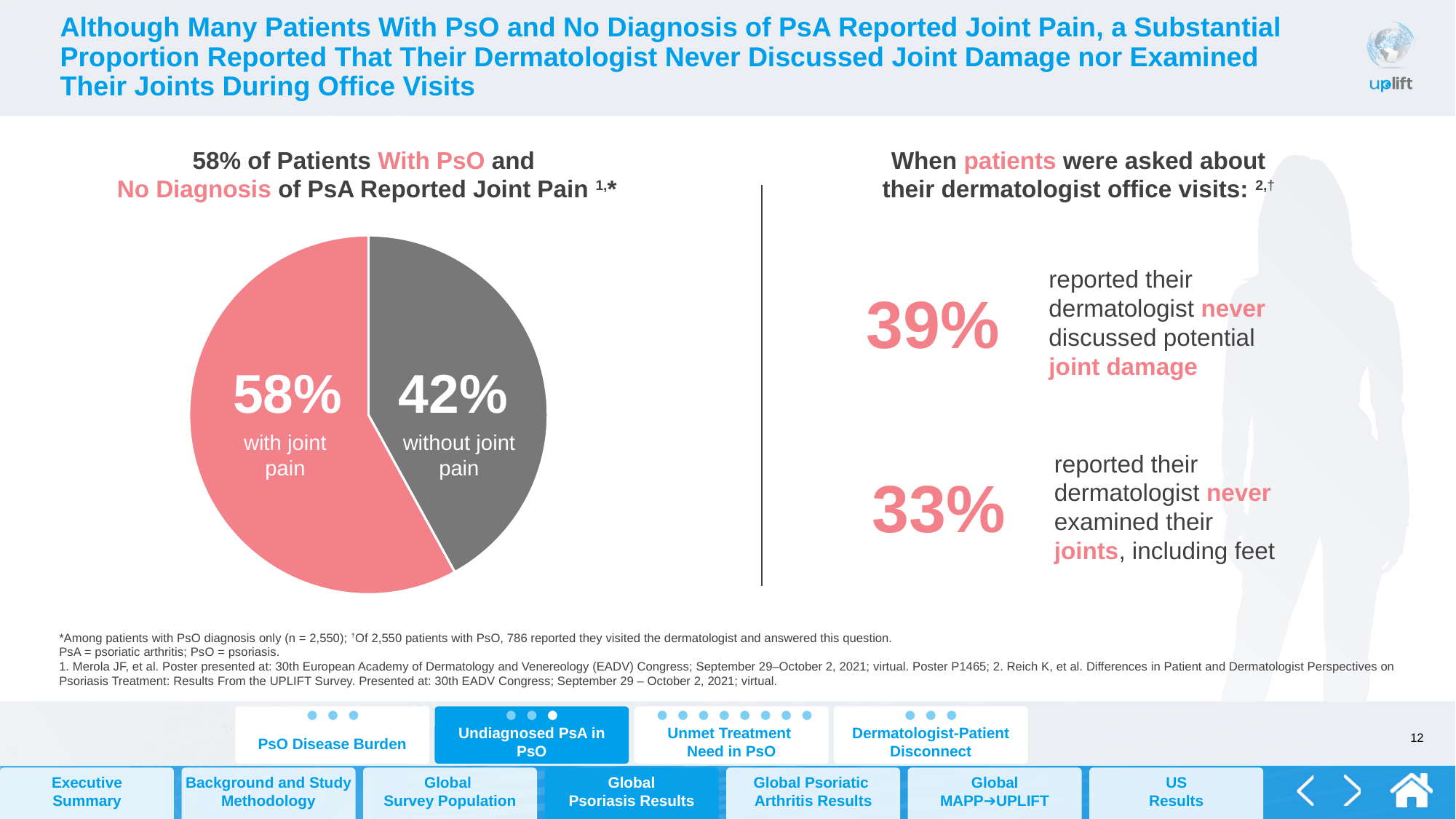
What percentage of patients in the pie chart are without joint pain? 42% What is the total of the two slices in the pie chart? 100% What colour is the 'with joint pain' slice of the pie chart? pink Which slice of the pie chart is the smallest? without joint pain What colour is the 'without joint pain' slice of the pie chart? grey What percentage of patients with PsO and no diagnosis of PsA reported joint pain, according to the pie chart? 58% Which slice of the pie chart is larger: with joint pain or without joint pain? with joint pain How many slices does the pie chart have? 2 Is the share of patients with joint pain greater or less than 50%? greater What is the difference in percentage points between the 'with joint pain' and 'without joint pain' slices? 16 What kind of chart is shown on the slide? pie chart